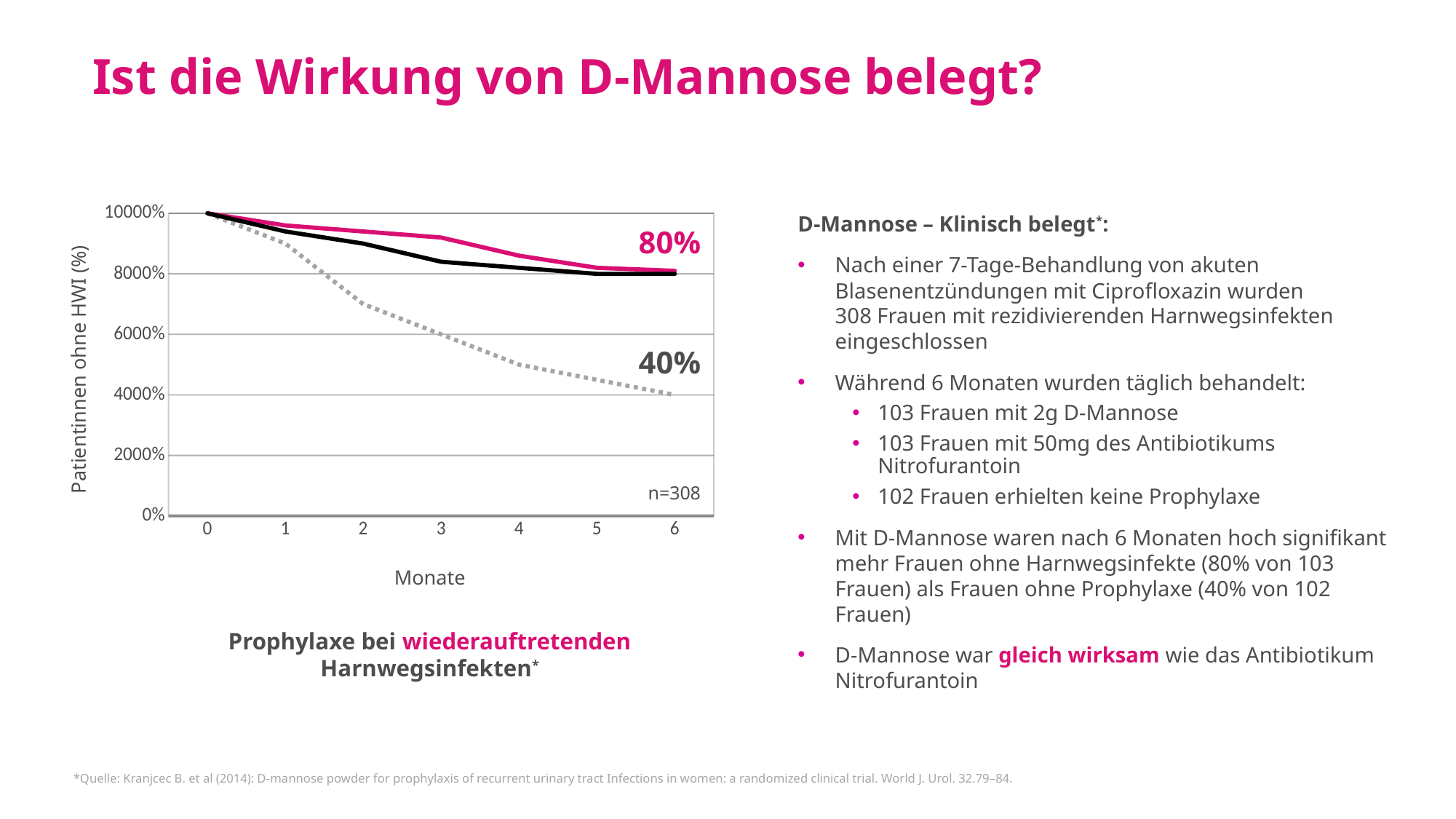
Do the values of the lines rise or fall as the months increase along the x axis? fall What value label is printed at the end of the grey dotted line? 40% At month 6, which line has the larger value: the pink line or the grey dotted line? the pink line How many points are marked on the x axis (Monate) of the chart? 7 What sample size annotation is printed inside the chart area? n=308 How many lines are plotted in the chart? 3 What is the difference between the printed end values of the pink line (80%) and the grey dotted line (40%)? 40% What value label is printed at the end of the pink line? 80% What is the title of the x axis of the chart? Monate What kind of chart is shown on the slide? line chart Is the value of the grey dotted line at month 3 greater or less than 8000%? less Which line is lowest at month 6? the grey dotted line